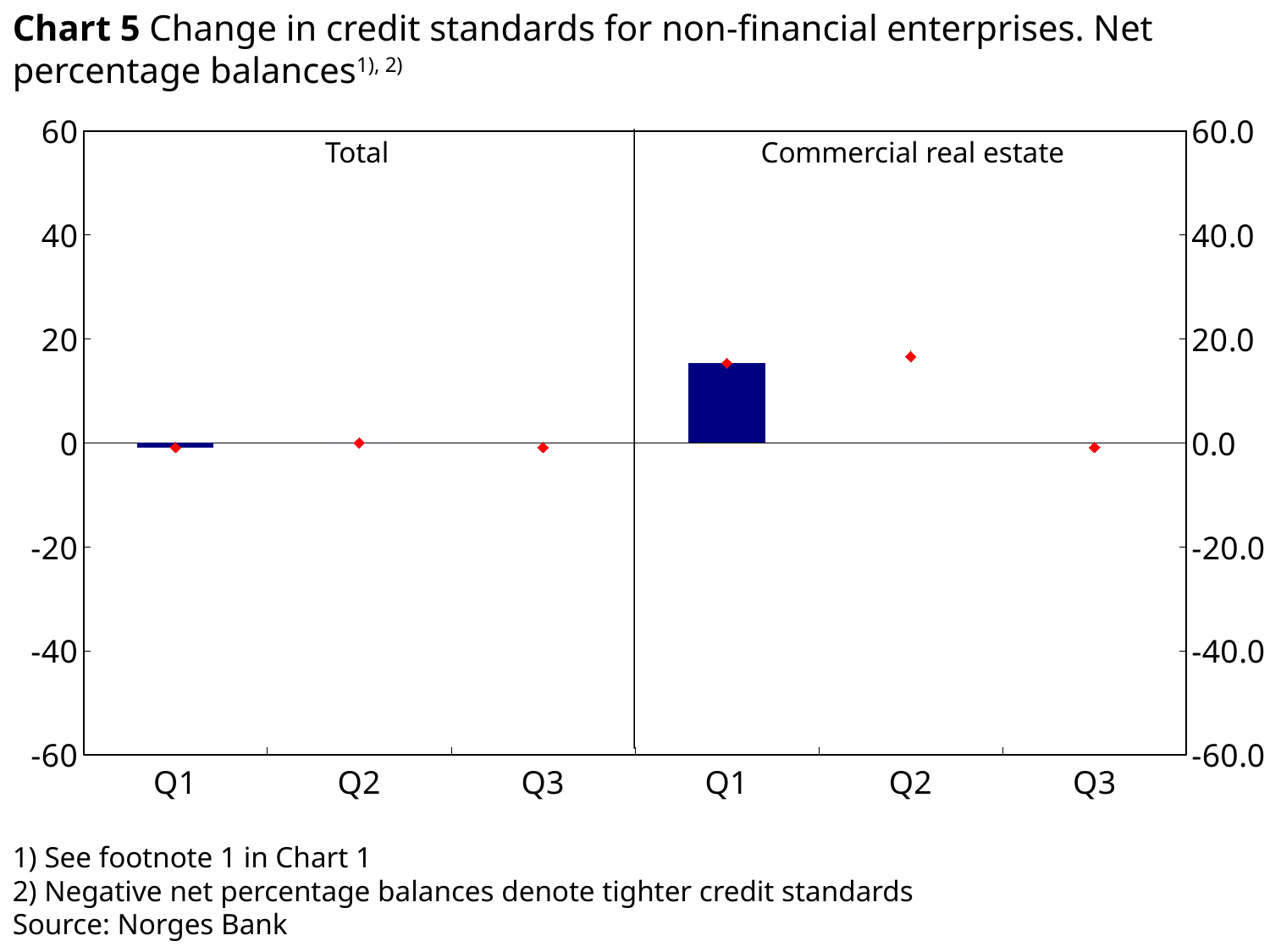
How many bars are plotted in Chart 5 in total? 2 Is the Q1 bar in the Commercial real estate panel greater or less than 0? greater Which is larger, the Q1 bar in the Total panel or the Q1 bar in the Commercial real estate panel? Commercial real estate Is the Q2 red marker in the Commercial real estate panel greater or less than 20? less What kind of chart is Chart 5? bar chart Is the Q1 bar in the Commercial real estate panel greater or less than 20? less In the Commercial real estate panel, which quarter has the lowest red marker? Q3 How many quarters are shown in each panel of Chart 5? 3 In the Commercial real estate panel, do the red markers rise or fall from Q2 to Q3? fall What is the highest value shown on the left y axis of Chart 5? 60 What are the two panels of Chart 5 labelled? Total and Commercial real estate